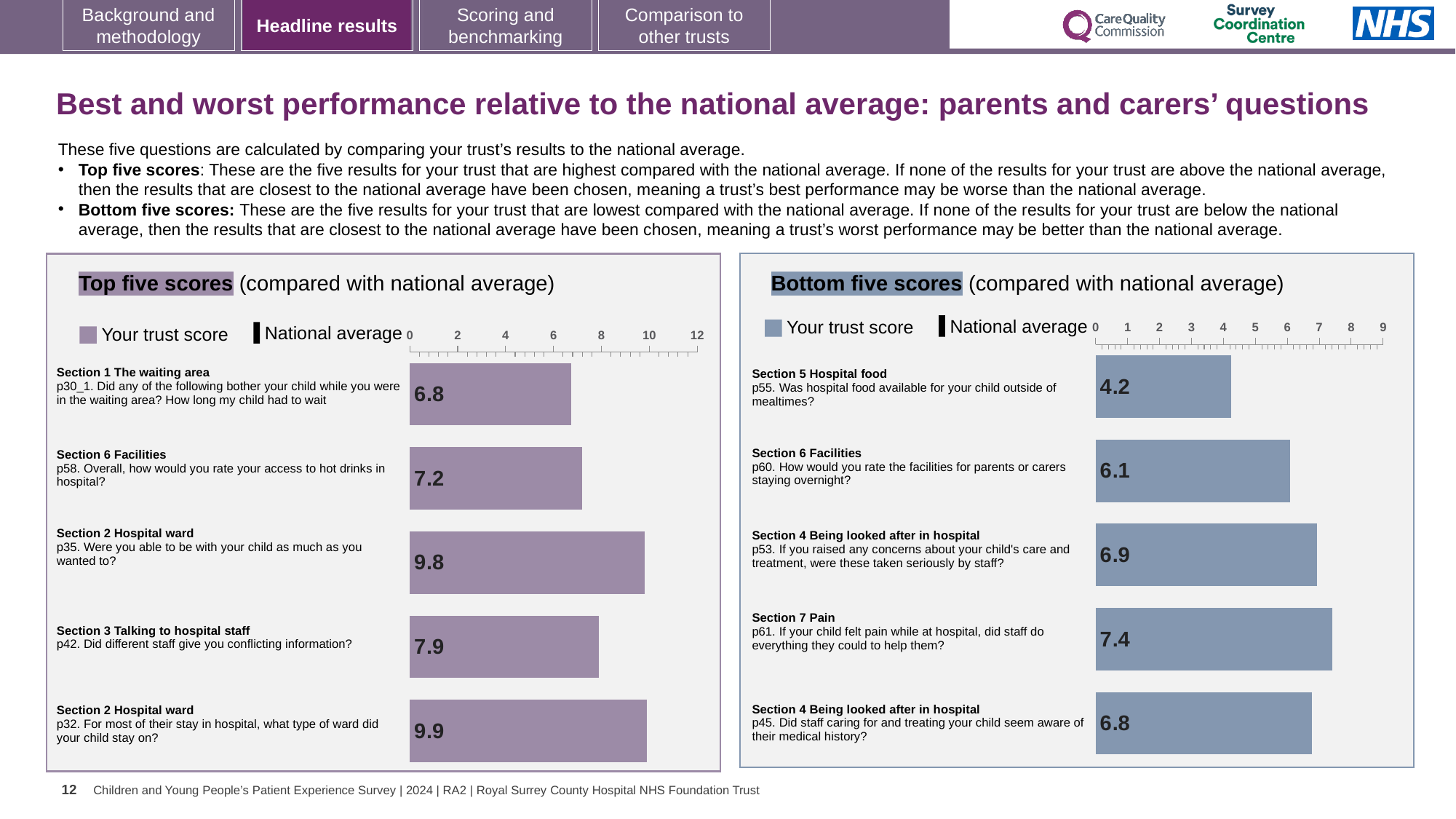
In the Top five scores chart, what is the trust score for p35 (being with your child as much as you wanted to)? 9.8 In the Top five scores chart, what is the trust score for p58 (access to hot drinks in hospital)? 7.2 What type of chart is the Bottom five scores chart? Bar chart In the Top five scores chart, what is the difference between the trust scores for p32 and p30_1? 3.1 How many questions are plotted in the Top five scores chart? 5 In the Bottom five scores chart, which question has the lowest trust score? p55. Was hospital food available for your child outside of mealtimes? In the Bottom five scores chart, what is the trust score for p55 (hospital food available outside of mealtimes)? 4.2 In the Top five scores chart, which question has the lowest trust score? p30_1. Did any of the following bother your child while you were in the waiting area? How long my child had to wait In the Bottom five scores chart, is the trust score for p45 greater or less than 6? greater In the Bottom five scores chart, what is the trust score for p61 (staff doing everything to help with pain)? 7.4 In the Bottom five scores chart, which has the larger trust score: p60 or p53? p53 In the Bottom five scores chart, which question has the highest trust score? p61. If your child felt pain while at hospital, did staff do everything they could to help them?